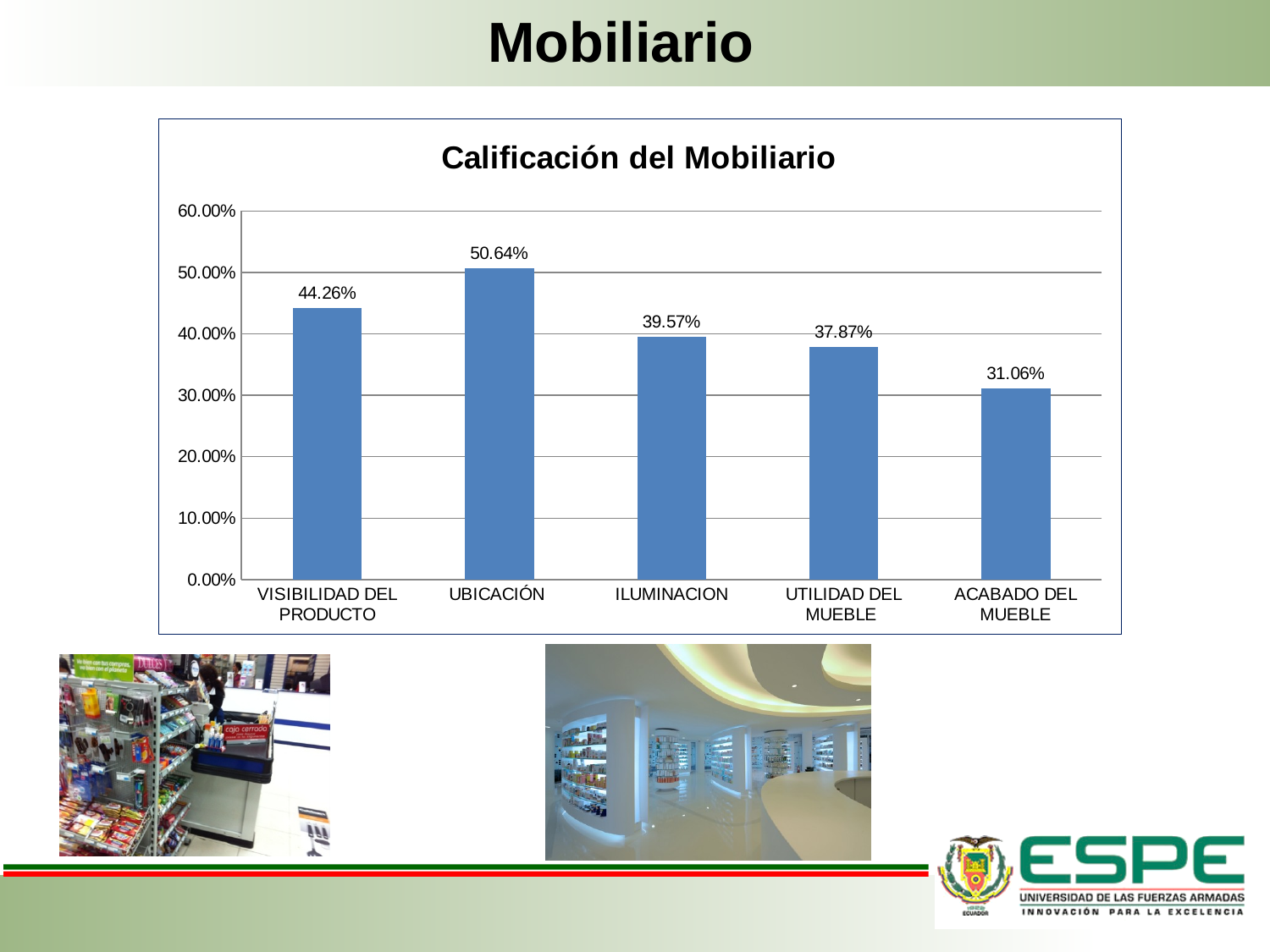
Which category has the lowest value? ACABADO DEL MUEBLE What is the difference between the values for UBICACIÓN and VISIBILIDAD DEL PRODUCTO? 6.38% What is the value for UBICACIÓN? 50.64% Is the value for UBICACIÓN greater or less than 50.00%? greater How many categories are shown on the chart? 5 Which is larger, the value for VISIBILIDAD DEL PRODUCTO or the value for UTILIDAD DEL MUEBLE? VISIBILIDAD DEL PRODUCTO What kind of chart is shown on the slide? bar chart What is the value for ILUMINACION? 39.57% What is the value for ACABADO DEL MUEBLE? 31.06% What is the difference between the values for ILUMINACION and UTILIDAD DEL MUEBLE? 1.70% What is the title of the chart? Calificación del Mobiliario Which category has the highest value? UBICACIÓN